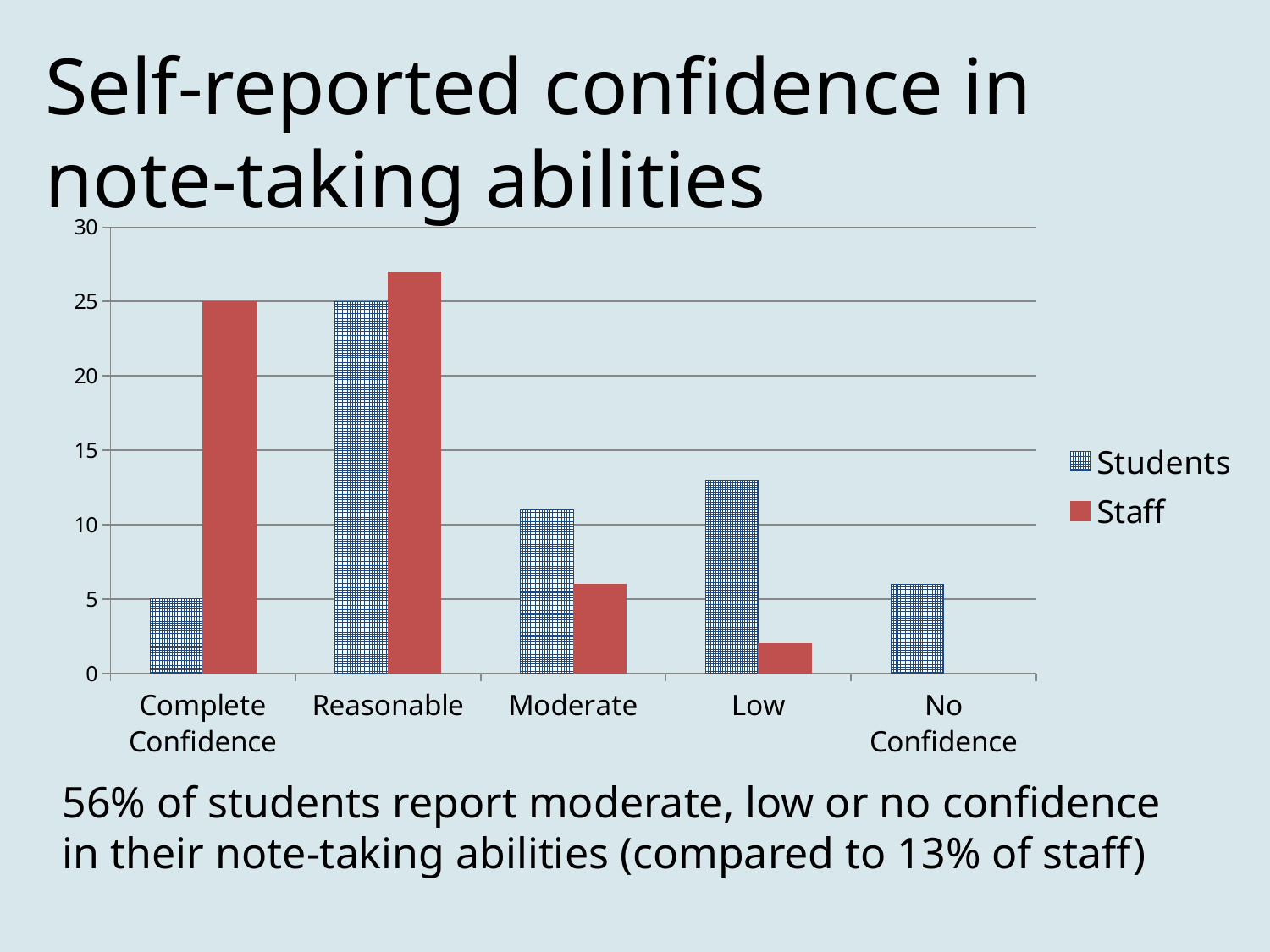
Which category has the highest value for Staff? Reasonable What is the difference between the Staff and Students values in the Complete Confidence category? 20 Is the value for Staff in the Moderate category greater or less than 10? less Which category has the lowest value for Students? Complete Confidence What kind of chart is shown on the slide? bar chart How many categories are shown on the x axis? 5 Is the value for Students in the Low category greater or less than 10? greater In the Complete Confidence category, which series has the larger value, Students or Staff? Staff What is the value for Students in the Reasonable category? 25 What is the value for Staff in the Complete Confidence category? 25 How many series does the legend list? 2 What is the value for Students in the Complete Confidence category? 5